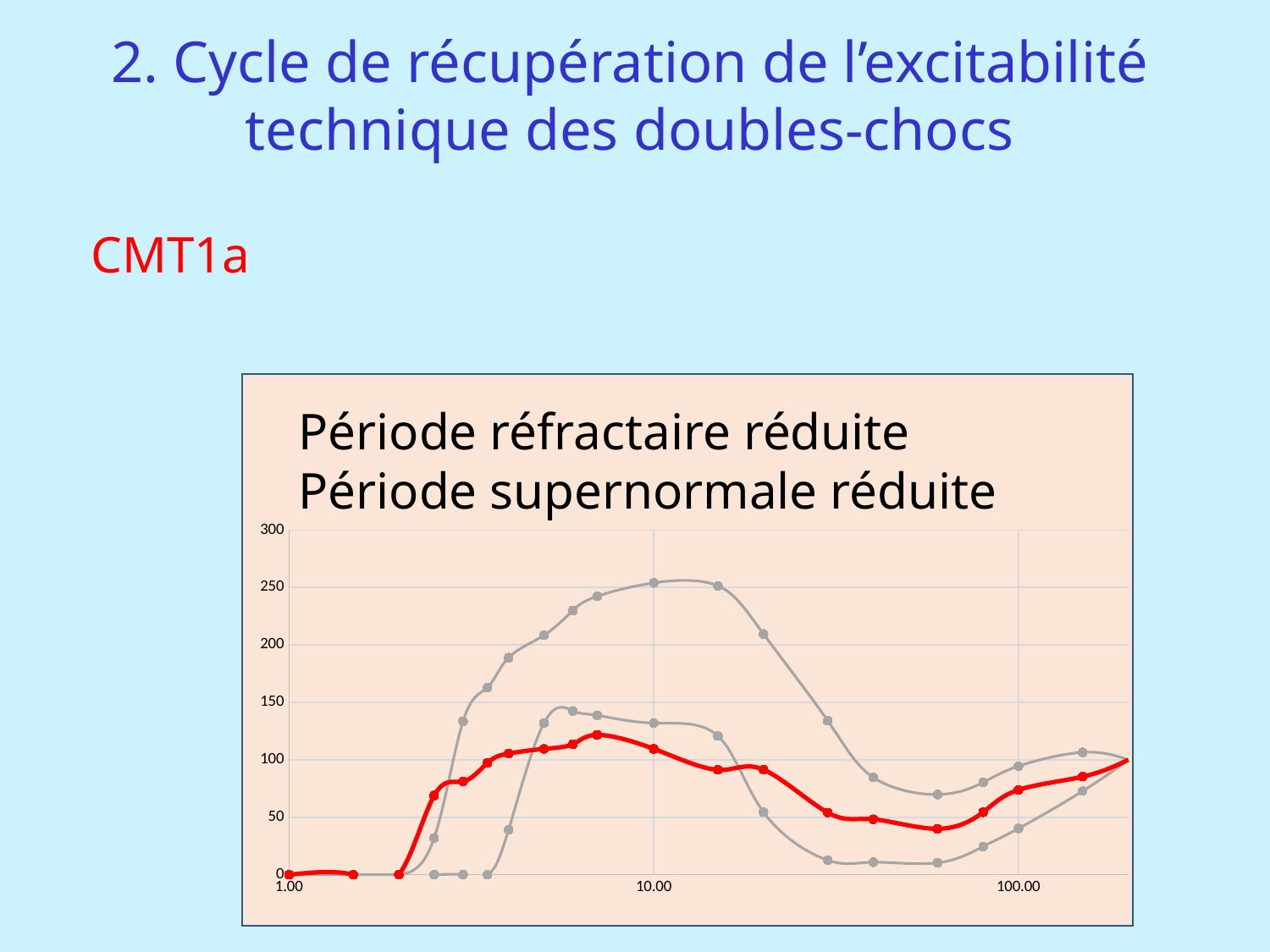
Is the peak value of the red line greater or less than 150? less How many lines are plotted on the chart? 3 What text is written as the chart's title? Période réfractaire réduite Période supernormale réduite Is the value of the red line at x = 100.00 greater or less than 100? less What is the value of the red line at x = 1.00? 0 At x = 10.00, which line is higher: the red line or the upper grey line? the upper grey line Is the value of the lower grey line at around x = 30 greater or less than 50? less What is the highest value shown on the y axis? 300 What kind of chart is shown on the slide? line chart Does the red line rise or fall between x = 10.00 and x = 60? fall